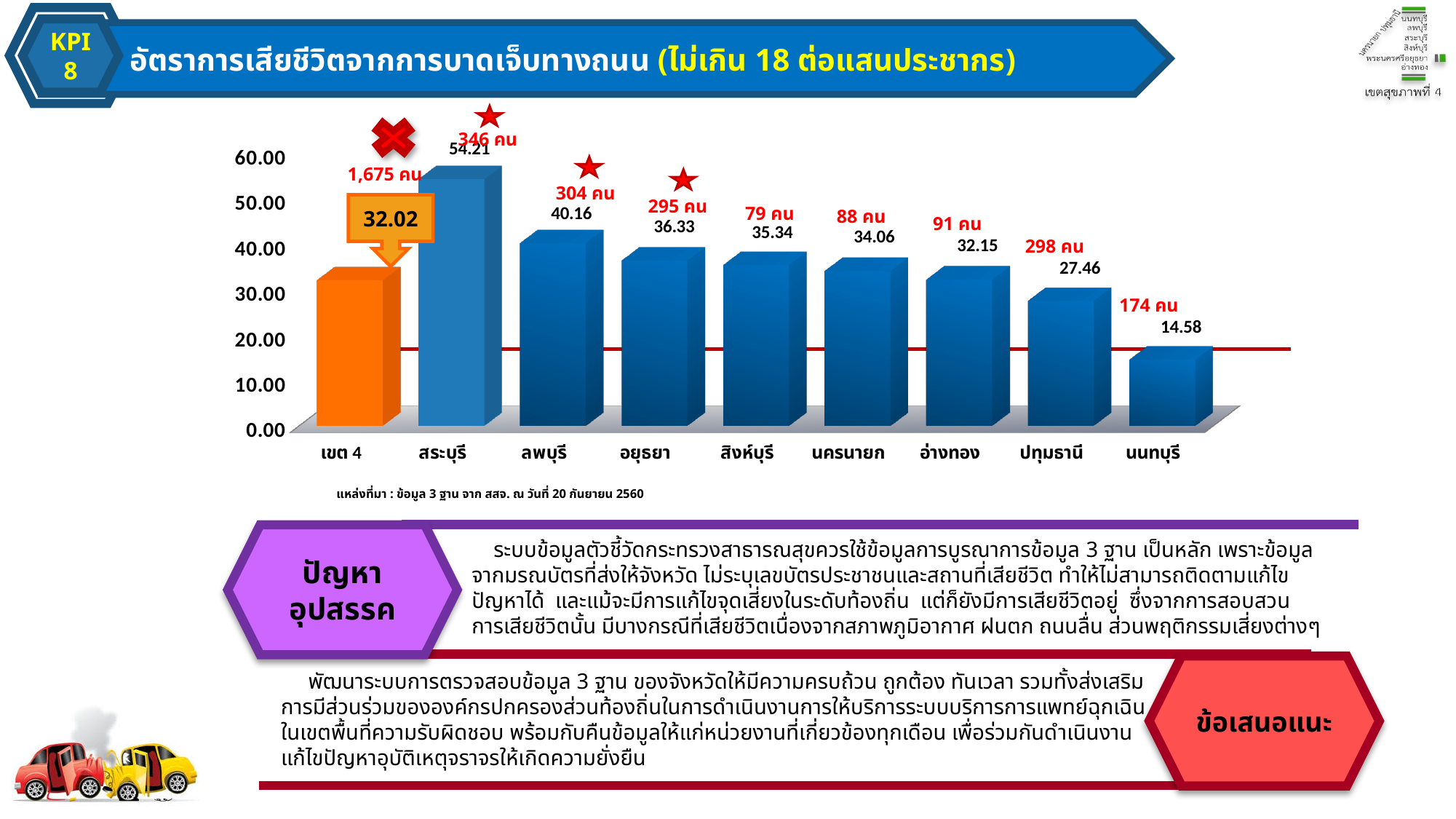
What is the value shown for ปทุมธานี? 27.46 Which province has the highest value in the chart? สระบุรี What is the value shown for นนทบุรี? 14.58 What number of people (คน) is labelled in red above the เขต 4 bar? 1,675 คน What is the value shown for เขต 4? 32.02 What kind of chart is shown on the slide? bar chart How many categories are shown on the x axis of the chart? 9 What is the value shown for สระบุรี? 54.21 Which category has the lowest value in the chart? นนทบุรี What is the difference between the values for สระบุรี and ลพบุรี? 14.05 Which is larger, the value for อยุธยา or the value for สิงห์บุรี? อยุธยา Do the values generally rise or fall from สระบุรี to นนทบุรี along the x axis? fall